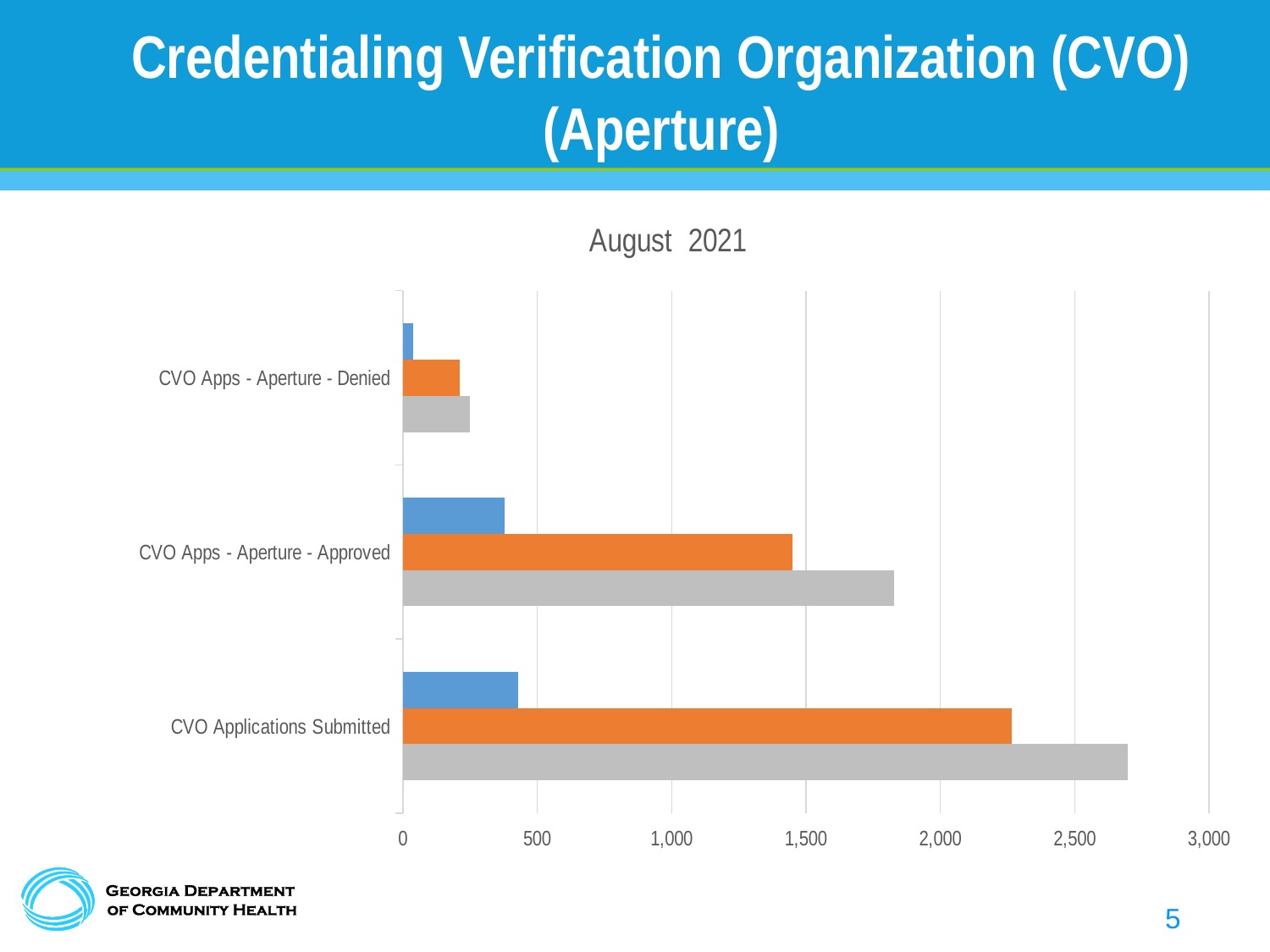
What kind of chart is shown on the slide? bar chart Is the gray bar for CVO Apps - Aperture - Denied greater or less than 500? less Is the gray bar for CVO Applications Submitted greater or less than 2,500? greater How many categories are shown on the chart? 3 Is the blue bar for CVO Applications Submitted greater or less than 500? less Which category has the shortest bars overall? CVO Apps - Aperture - Denied Which category has the longest bars overall? CVO Applications Submitted What is the title of the chart? August 2021 Within CVO Apps - Aperture - Approved, which bar is longer, the orange bar or the gray bar? the gray bar How many bars are shown for each category? 3